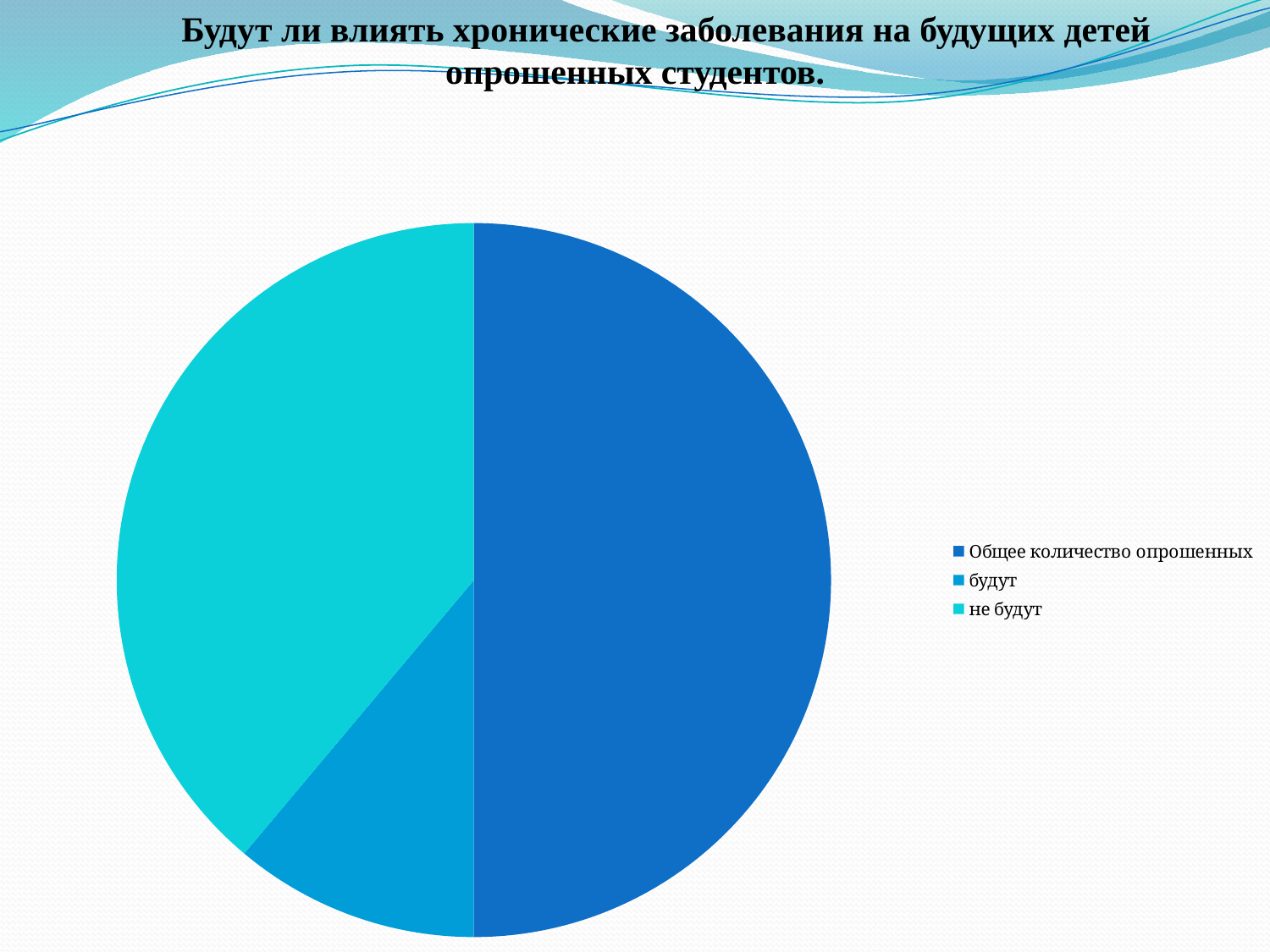
Which slice is larger in the pie chart, "будут" or "не будут"? не будут Which legend entry of the pie chart is shown in the darkest blue colour? Общее количество опрошенных Which slice is larger in the pie chart, "Общее количество опрошенных" or "не будут"? Общее количество опрошенных What is the title of the slide containing the pie chart? Будут ли влиять хронические заболевания на будущих детей опрошенных студентов. Which slice of the pie chart is the smallest? будут How many slices does the pie chart have? 3 How many entries does the legend of the pie chart list? 3 Which slice of the pie chart is the largest? Общее количество опрошенных What kind of chart is shown on the slide? pie chart